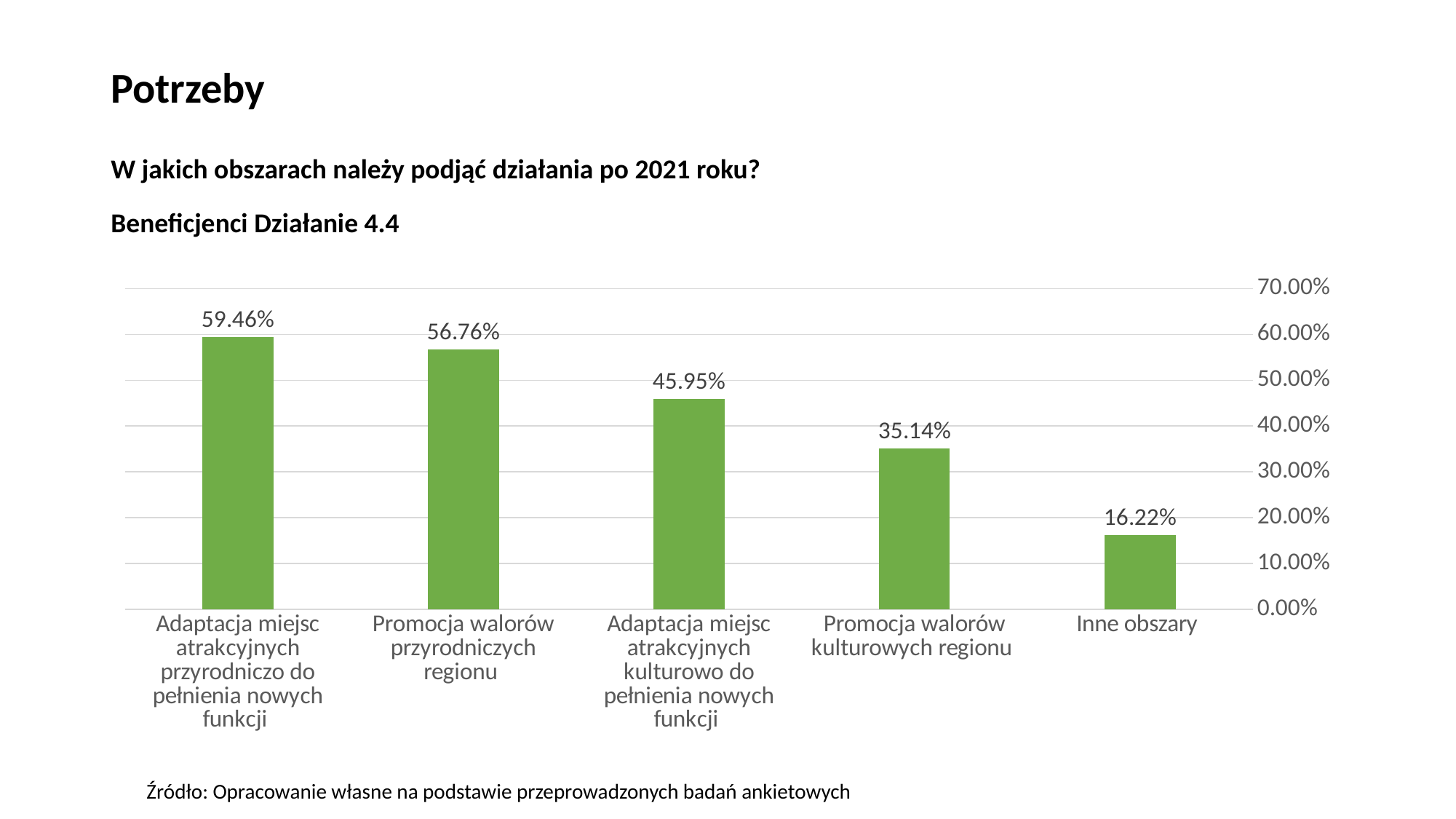
Do the values rise or fall from left to right along the x axis? fall Which category has the highest value? Adaptacja miejsc atrakcyjnych przyrodniczo do pełnienia nowych funkcji Which category has the lowest value? Inne obszary What is the difference between the values for "Adaptacja miejsc atrakcyjnych przyrodniczo do pełnienia nowych funkcji" and "Promocja walorów przyrodniczych regionu"? 2.70% What is the value for "Promocja walorów kulturowych regionu"? 35.14% How many categories are shown in the chart? 5 What is the value for "Adaptacja miejsc atrakcyjnych kulturowo do pełnienia nowych funkcji"? 45.95% What kind of chart is shown on the slide? bar chart Which is larger: the value for "Promocja walorów kulturowych regionu" or the value for "Inne obszary"? Promocja walorów kulturowych regionu What is the value for "Inne obszary"? 16.22% Is the value for "Adaptacja miejsc atrakcyjnych kulturowo do pełnienia nowych funkcji" greater or less than 40.00%? greater What is the value for "Promocja walorów przyrodniczych regionu"? 56.76%